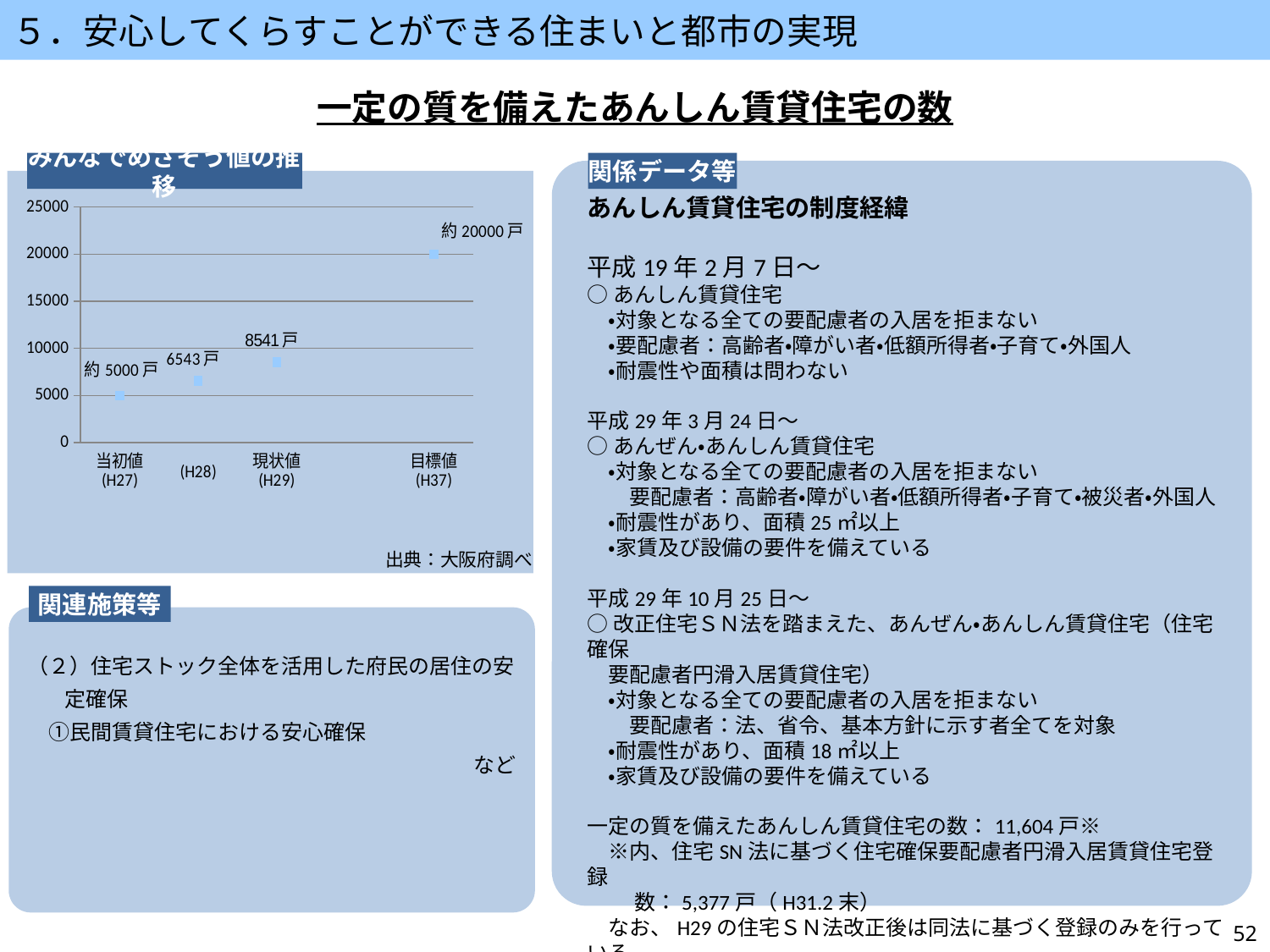
Is the value for 目標値 (H37) greater or less than 15000? greater What is the difference between the values for 現状値 (H29) and (H28)? 1998 戸 Which category has the lowest value in the chart? 当初値 (H27) What is the value for 現状値 (H29) in the chart? 8541 戸 What source is cited below the chart? 大阪府調べ What is the value for (H28) in the chart? 6543 戸 Do the values rise or fall from 当初値 (H27) to 目標値 (H37)? rise Which category has the highest value in the chart? 目標値 (H37) How many data points are plotted in the chart? 4 What is the title of the chart? みんなでめざそう値の推移 Is the value for 当初値 (H27) greater or less than 10000? less Which is larger, the value for 現状値 (H29) or the value for (H28)? 現状値 (H29)